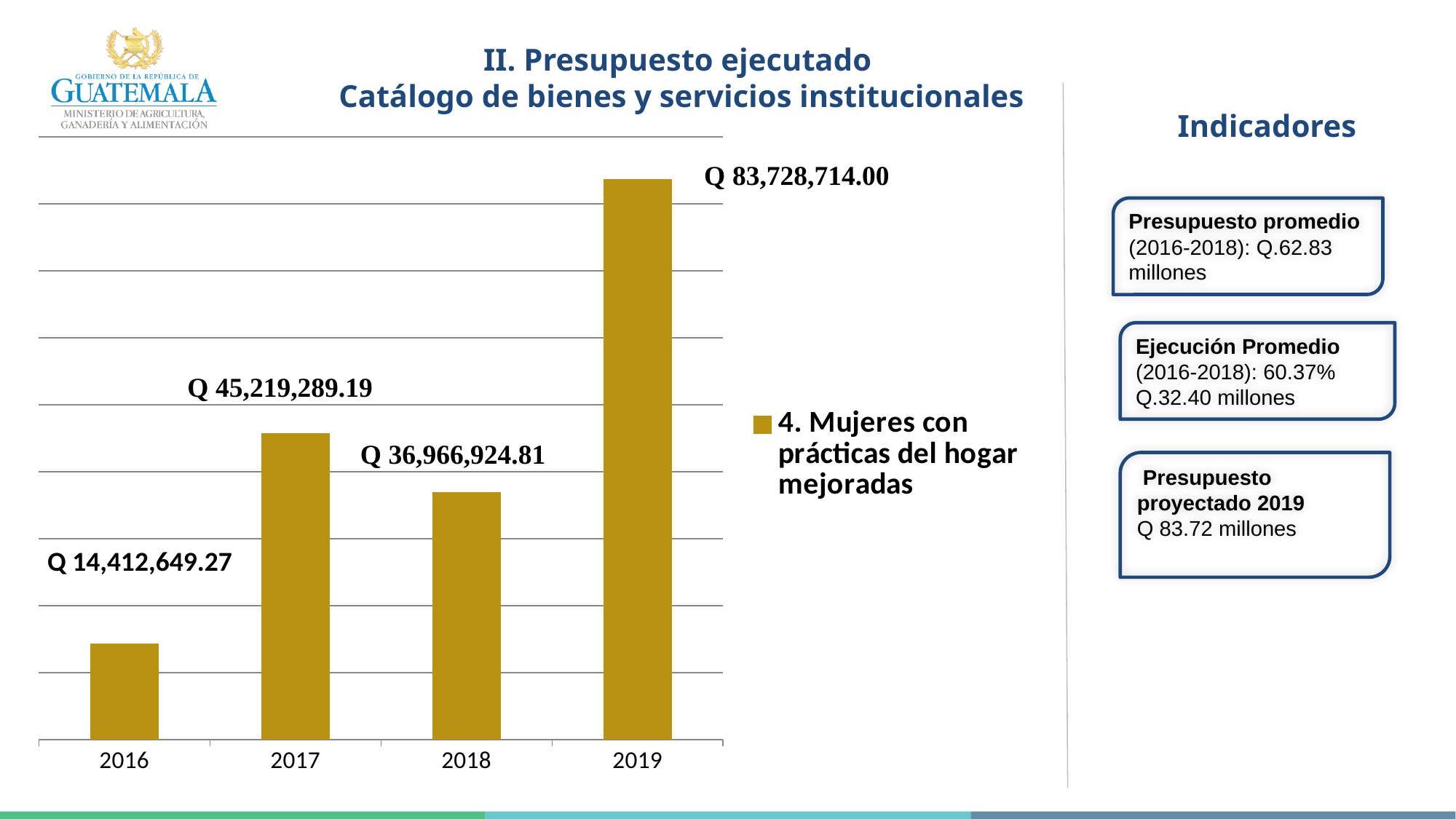
What is the difference between the values for 2019 and 2018? Q 46,761,789.19 How many years are shown on the x axis? 4 What is the value for 2017? Q 45,219,289.19 What is the value for 2016? Q 14,412,649.27 Which is larger, the value for 2017 or the value for 2018? 2017 What is the value for 2018? Q 36,966,924.81 What is the value for 2019? Q 83,728,714.00 What is the series name shown in the legend? 4. Mujeres con prácticas del hogar mejoradas What is the difference between the values for 2017 and 2016? Q 30,806,639.92 Which year has the lowest value? 2016 Which year has the highest value? 2019 What kind of chart is shown on the slide? Bar chart